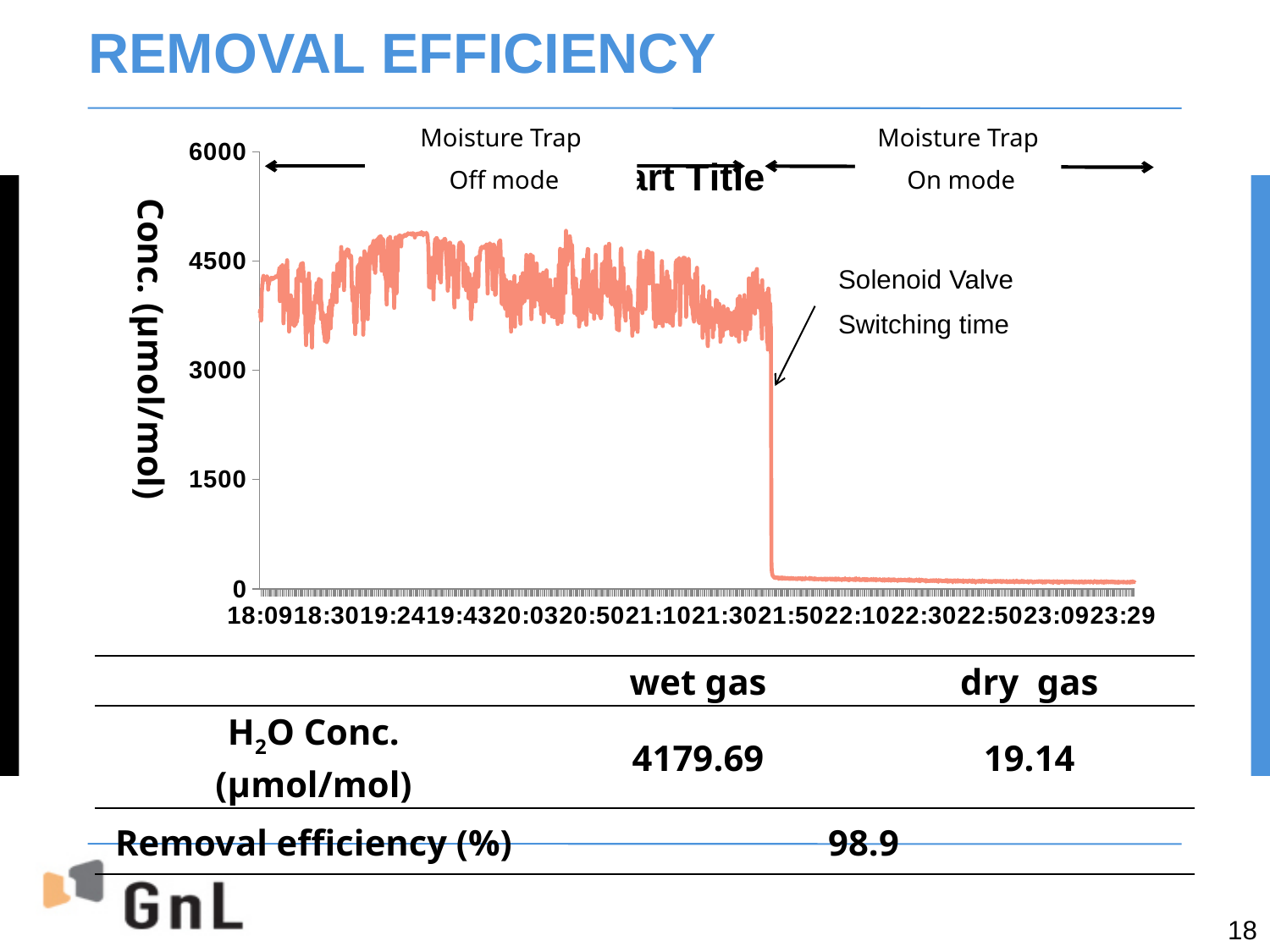
What is the label of the vertical axis of the chart? Conc. (µmol/mol) Do the plotted concentration values rise or fall overall from left to right along the x axis? fall What event does the arrow annotation on the chart point to at the sharp drop in concentration? Solenoid Valve Switching time What kind of chart is shown on the slide? line chart Is the concentration value at 22:50 greater or less than 3000? less Is the concentration value at 18:30 greater or less than 1500? greater Is the concentration value at 22:30 greater or less than 1500? less